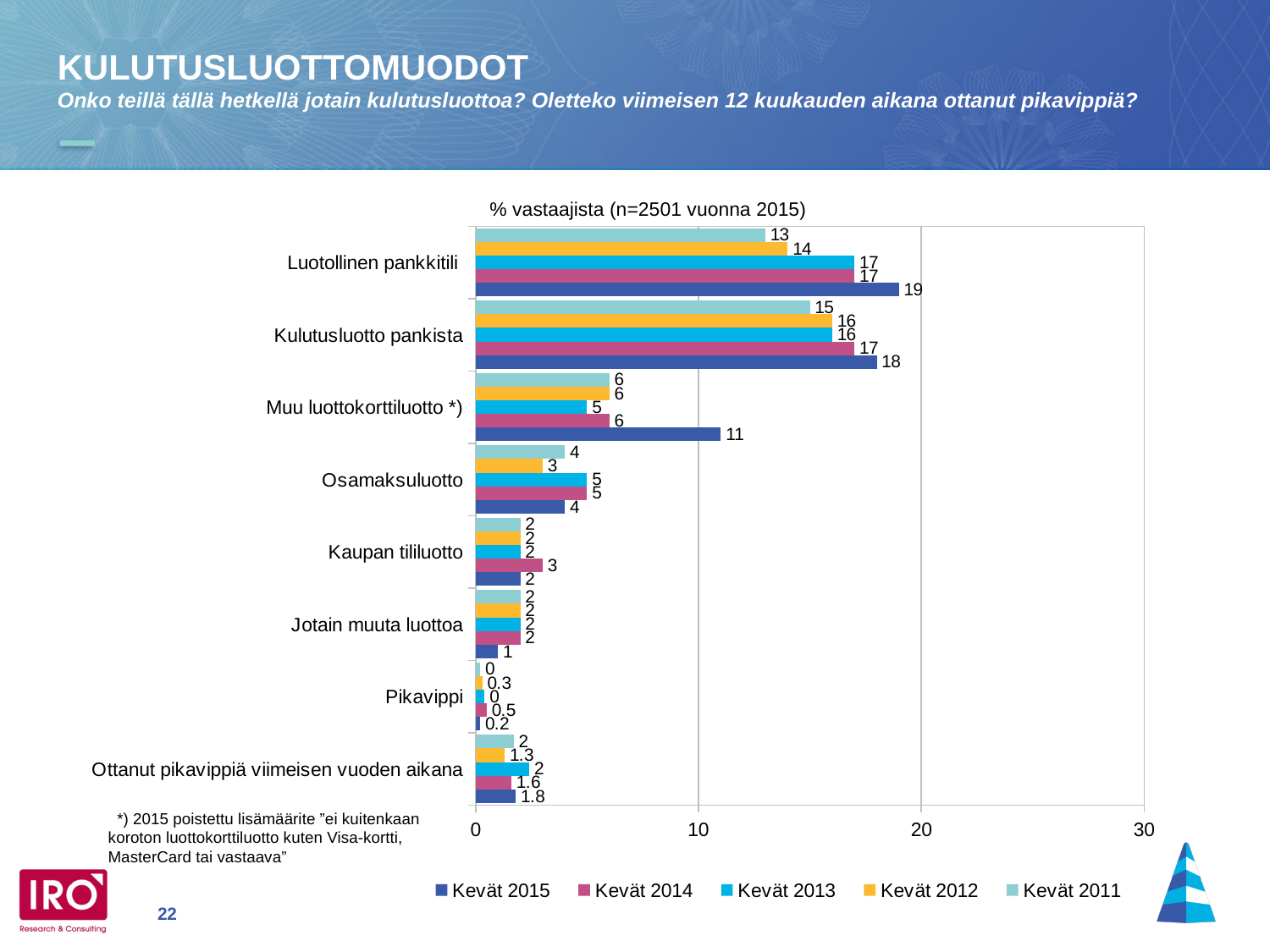
What is the difference between the Kevät 2015 and Kevät 2011 values for Luotollinen pankkitili? 6 How many series does the legend list? 5 What is the value for Pikavippi in the Kevät 2014 series? 0.5 What is the value for Muu luottokorttiluotto *) in the Kevät 2015 series? 11 Which is larger for Muu luottokorttiluotto *): the Kevät 2015 value or the Kevät 2014 value? Kevät 2015 How many categories are shown on the vertical axis of the chart? 8 Is the Kevät 2015 value for Kulutusluotto pankista greater or less than 10? greater What is the title of the chart? % vastaajista (n=2501 vuonna 2015) What is the value for Luotollinen pankkitili in the Kevät 2015 series? 19 What is the value for Ottanut pikavippiä viimeisen vuoden aikana in the Kevät 2012 series? 1.3 Which category has the highest value in the Kevät 2015 series? Luotollinen pankkitili What kind of chart is shown on the slide? bar chart